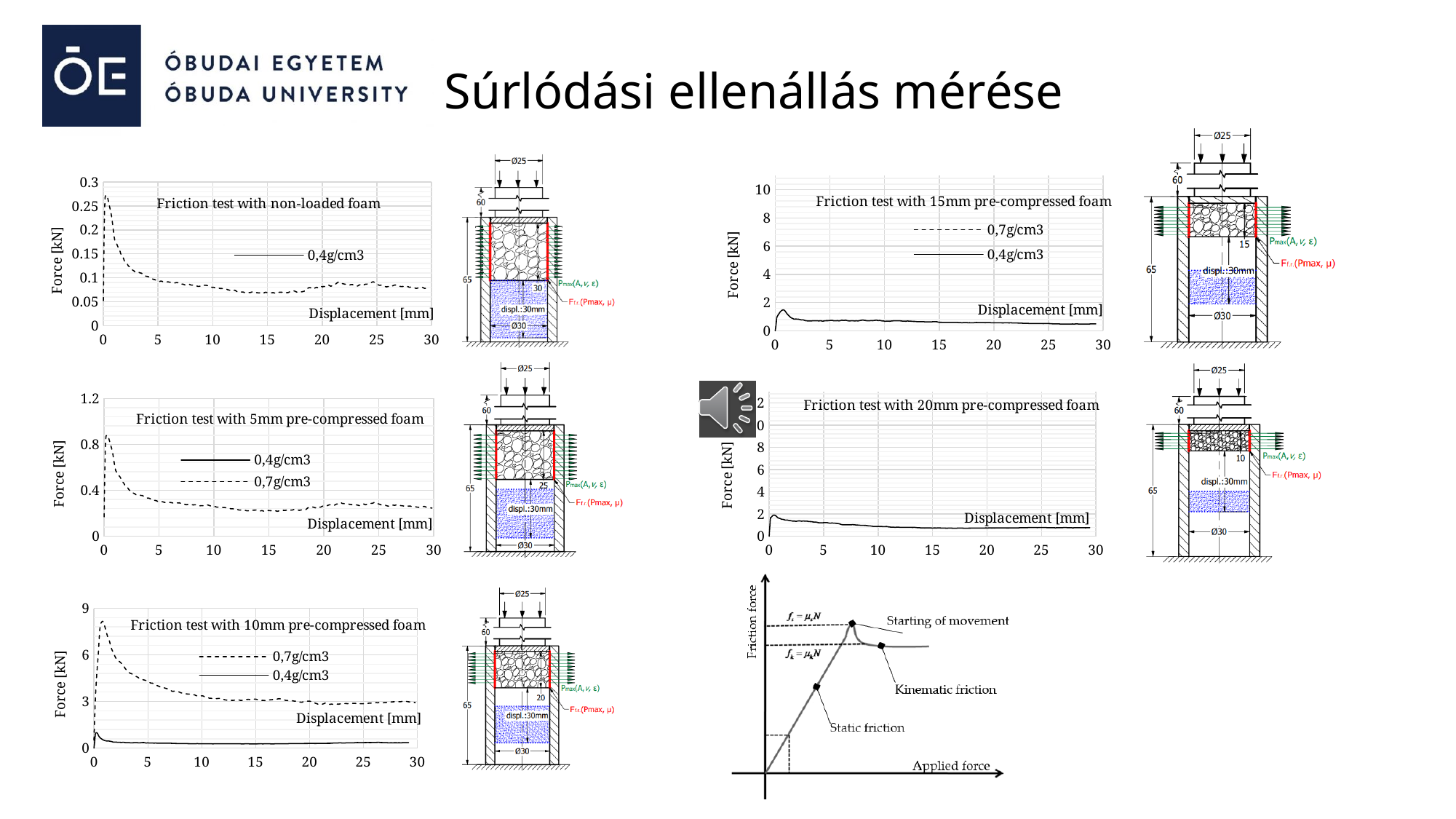
In 'Friction test with 10mm pre-compressed foam', is the value of the 0,4g/cm3 series at 20 mm displacement greater or less than 3? less In 'Friction test with 15mm pre-compressed foam', is the force at 20 mm displacement greater or less than 2? less What kind of chart is 'Friction test with non-loaded foam'? line chart In 'Friction test with 5mm pre-compressed foam', after the initial peak, does the 0,7g/cm3 force rise or fall as displacement increases? fall In 'Friction test with 5mm pre-compressed foam', is the value of the 0,7g/cm3 series at 15 mm displacement greater or less than 0.4? less In 'Friction test with 10mm pre-compressed foam', which series is higher at a displacement of 10 mm, 0,4g/cm3 or 0,7g/cm3? 0,7g/cm3 How many series does the legend of 'Friction test with 5mm pre-compressed foam' list? 2 How many series does the legend of 'Friction test with non-loaded foam' list? 1 What is the y-axis label of the 'Friction test with 20mm pre-compressed foam' chart? Force [kN]